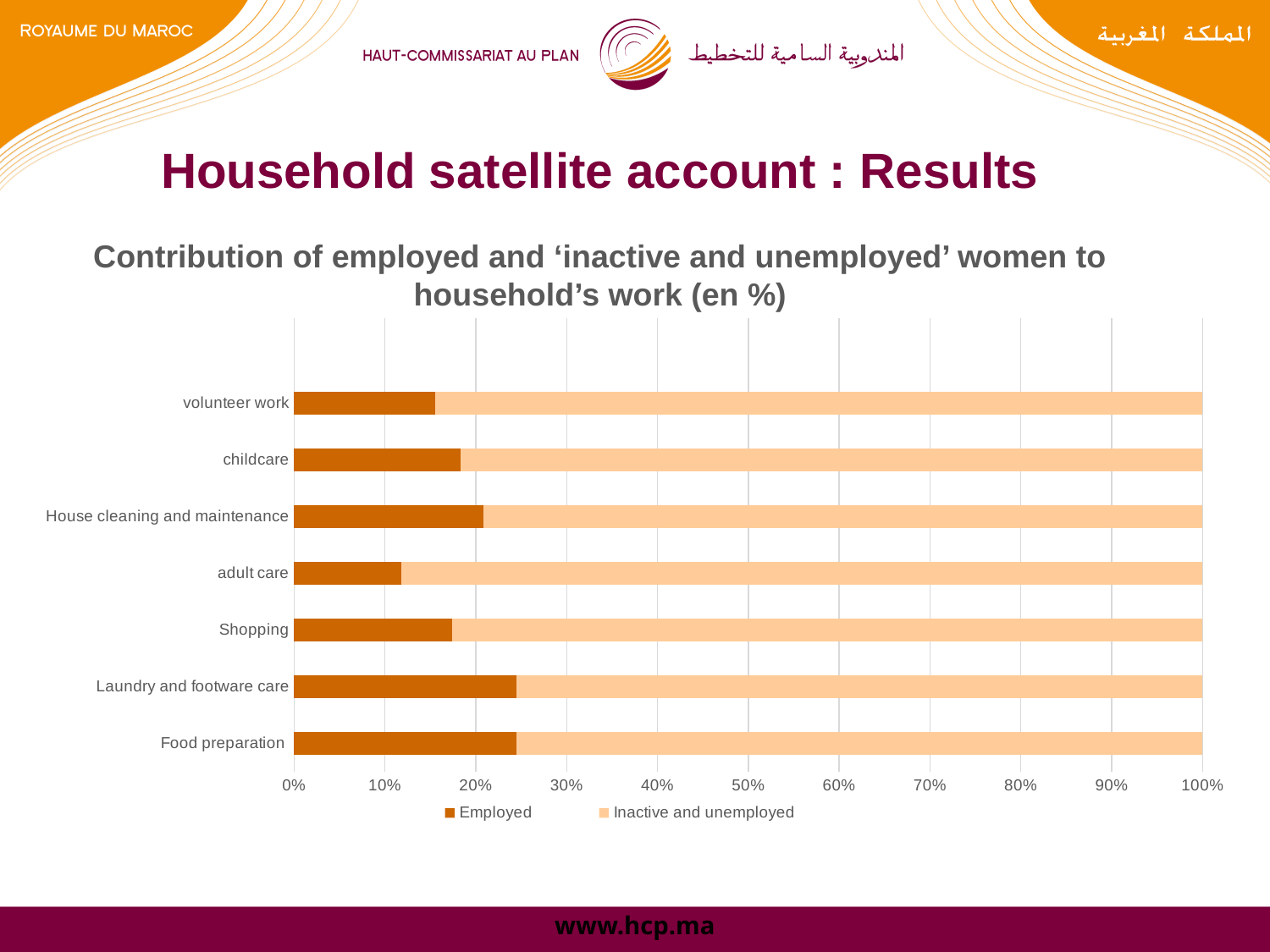
Is the Employed value for adult care greater or less than 10%? greater Which has the larger Employed share, House cleaning and maintenance or volunteer work? House cleaning and maintenance What are the two series named in the chart legend? Employed; Inactive and unemployed Is the Employed value for volunteer work greater or less than 20%? less Is the Employed value for Laundry and footware care greater or less than 20%? greater Which has the larger Employed share, Laundry and footware care or adult care? Laundry and footware care How many categories of household work are shown on the chart? 7 How many series does the chart legend list? 2 Which category has the lowest Employed share? adult care What kind of chart is shown on the slide? bar chart